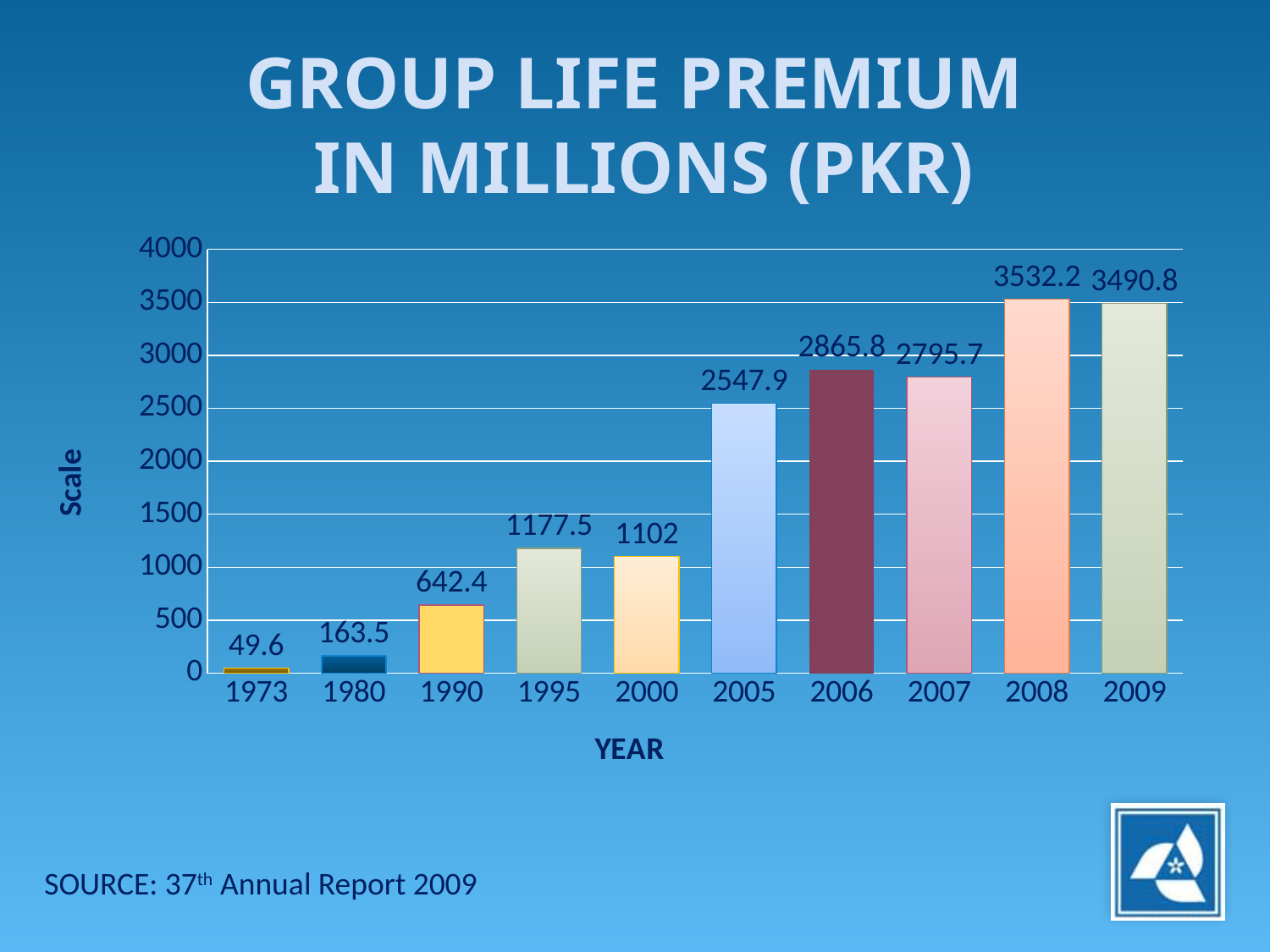
What is the difference between the values for 2008 and 2009? 41.4 What is the group life premium value for 1973? 49.6 Which year has the lowest group life premium? 1973 What is the group life premium value for 2005? 2547.9 Which year has the highest group life premium? 2008 Is the value for 2005 greater or less than 2000? greater Which is larger, the value for 2006 or the value for 2007? 2006 What is the label of the x axis? YEAR How many years are shown on the x axis? 10 What is the group life premium value for 1990? 642.4 What is the difference between the values for 1995 and 2000? 75.5 What kind of chart is shown on the slide? bar chart